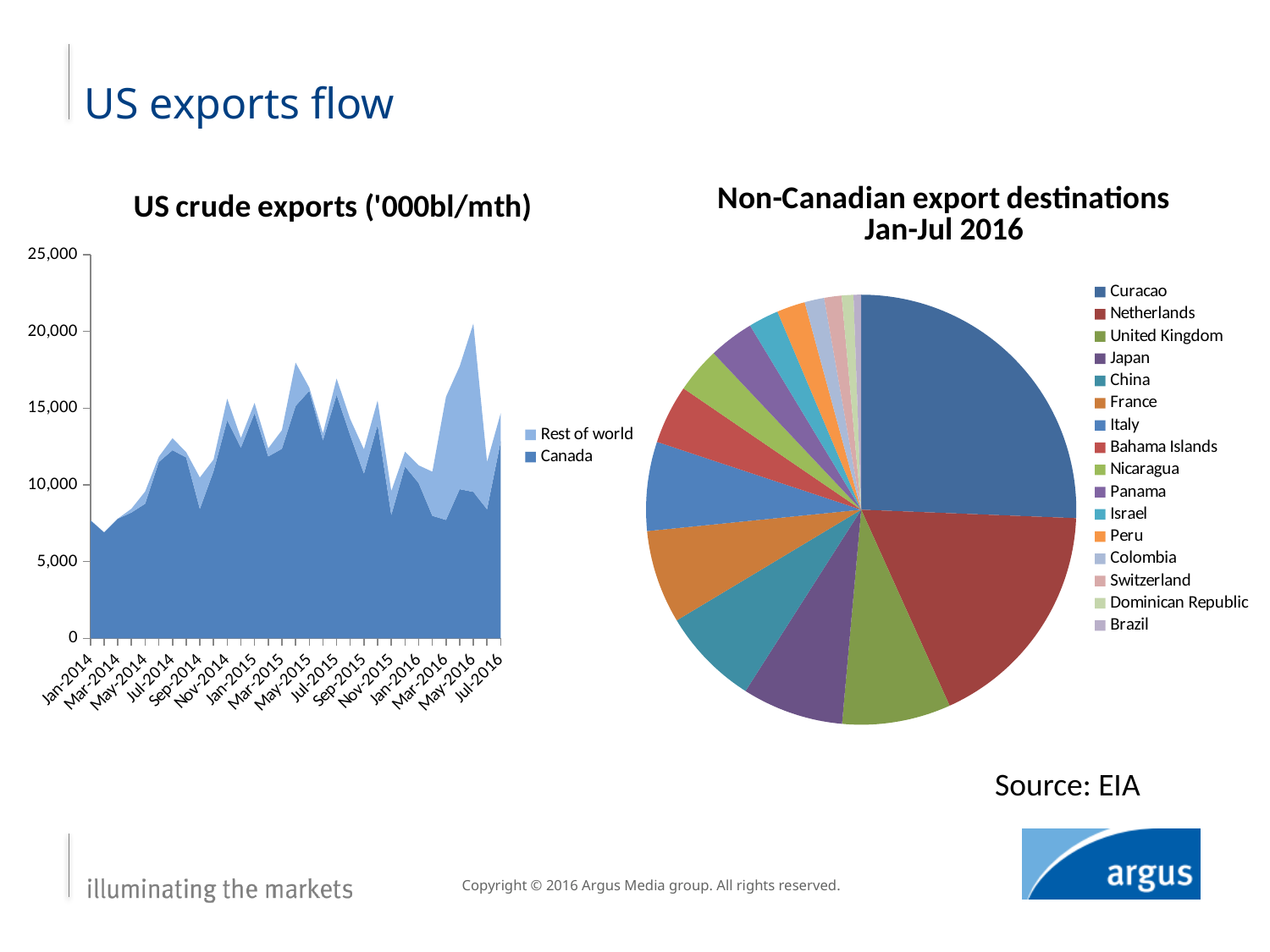
What is the highest value shown on the y-axis of the 'US crude exports ('000bl/mth)' chart? 25,000 In the 'US crude exports ('000bl/mth)' chart, is the total value for May-2016 greater or less than 15,000? greater In the 'US crude exports ('000bl/mth)' chart, do total exports rise or fall between Jan-2014 and Jul-2014? Rise In the 'Non-Canadian export destinations Jan-Jul 2016' pie chart, which destination has the largest slice? Curacao In the 'Non-Canadian export destinations Jan-Jul 2016' pie chart, which slice is larger, Netherlands or United Kingdom? Netherlands How many destinations does the legend of the 'Non-Canadian export destinations Jan-Jul 2016' pie chart list? 16 How many series does the legend of the 'US crude exports ('000bl/mth)' chart list? 2 In the 'US crude exports ('000bl/mth)' chart, is the total value for Jan-2014 greater or less than 10,000? less What type of chart is the 'US crude exports ('000bl/mth)' chart? Stacked area chart In the 'Non-Canadian export destinations Jan-Jul 2016' pie chart, which slice is larger, Curacao or Italy? Curacao What type of chart is the 'Non-Canadian export destinations Jan-Jul 2016' chart? Pie chart In the 'US crude exports ('000bl/mth)' chart, which series accounts for the larger share of exports across the period, Canada or Rest of world? Canada